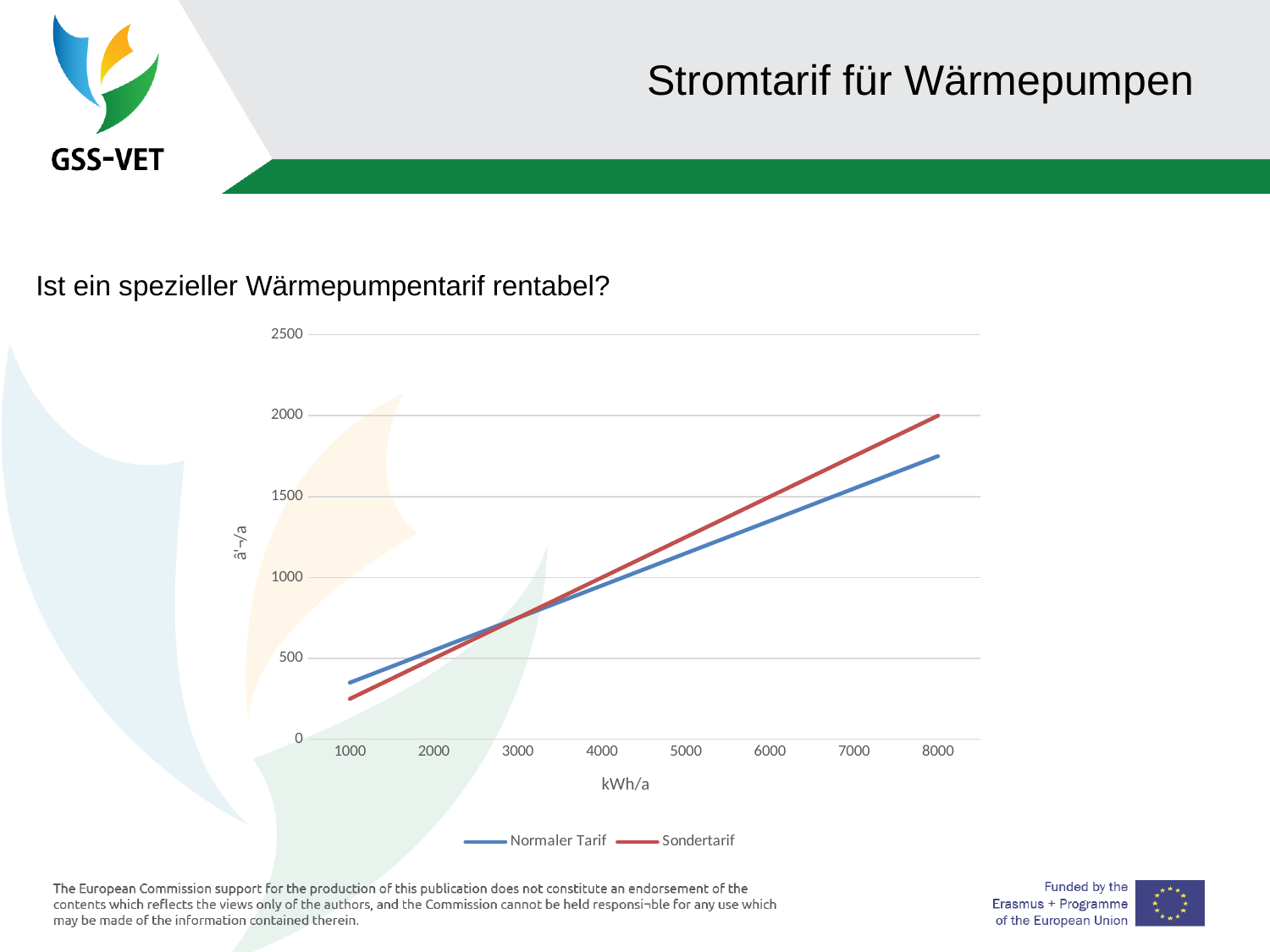
Is the value for Normaler Tarif at 8000 kWh/a greater or less than 1500? greater What is the label of the x axis? kWh/a At 1000 kWh/a, which series has the higher value, Normaler Tarif or Sondertarif? Normaler Tarif What are the two series named in the legend? Normaler Tarif and Sondertarif At 8000 kWh/a, which series has the higher value, Normaler Tarif or Sondertarif? Sondertarif Is the value for Sondertarif at 1000 kWh/a greater or less than 500? less How many series does the legend list? 2 Do the values of the Sondertarif line rise or fall as kWh/a increases? rise Do the values of the Normaler Tarif line rise or fall as kWh/a increases? rise Is the value for Normaler Tarif at 1000 kWh/a greater or less than 500? less What kind of chart is shown on the slide? line chart How many tick values are shown along the x axis? 8